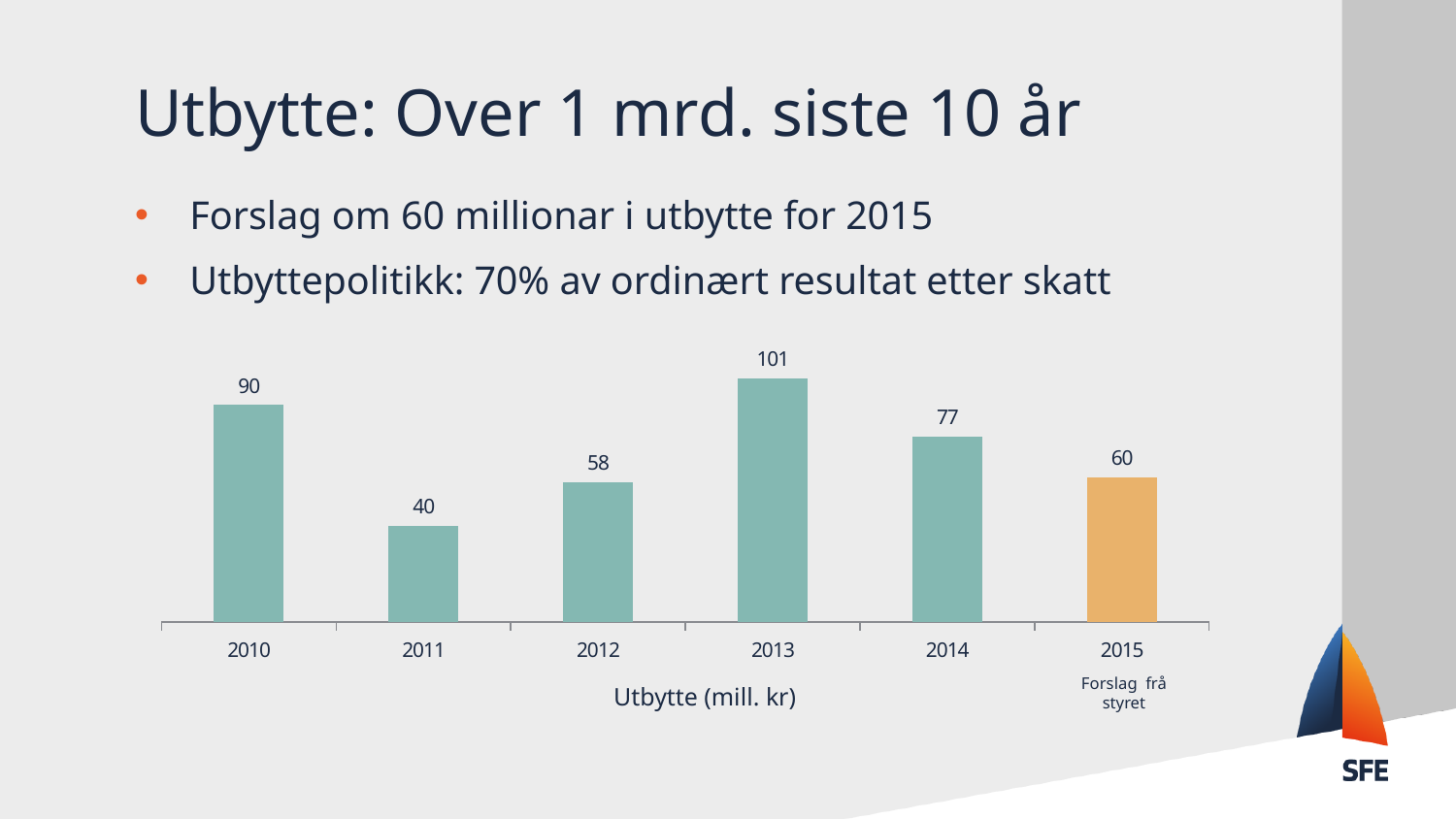
What is the value for 2013? 101 What is the difference between the values for 2010 and 2011? 50 Do the values rise or fall from 2013 to 2015? fall What kind of chart is shown on the slide? bar chart How many years are shown on the chart? 6 What is the value for 2010? 90 Which is larger, the value for 2012 or the value for 2014? 2014 Which year has the lowest value? 2011 What is the value for 2015? 60 What is the difference between the values for 2013 and 2014? 24 Which year has the highest value? 2013 What is the label shown below the x axis of the chart? Utbytte (mill. kr)